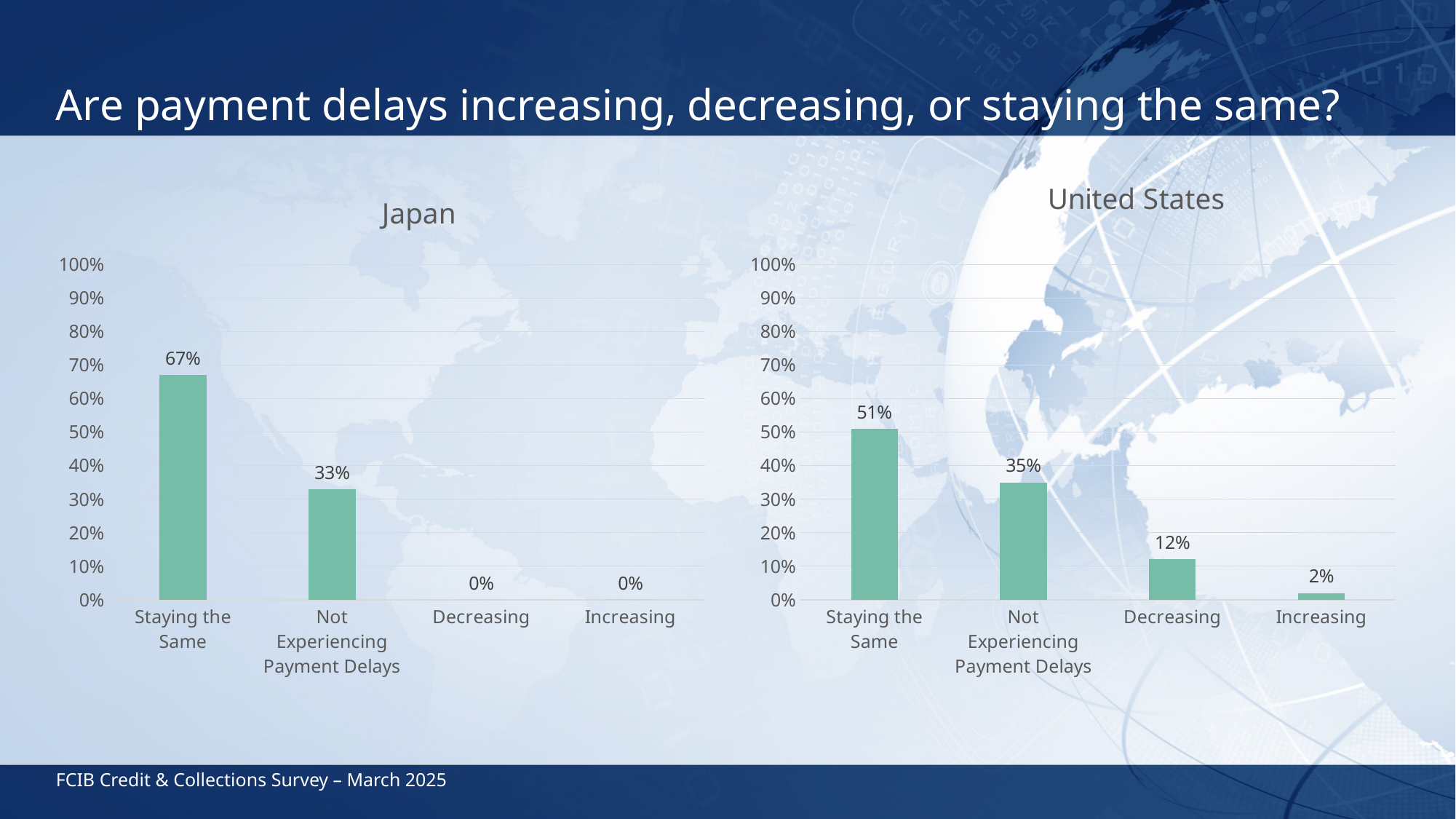
In the Japan chart, what is the value for Decreasing? 0% In the Japan chart, what is the value for Not Experiencing Payment Delays? 33% In the United States chart, which category has the lowest value? Increasing In the United States chart, what is the value for Increasing? 2% In the United States chart, what is the value for Decreasing? 12% In the United States chart, what is the difference between Staying the Same and Not Experiencing Payment Delays? 16% In the Japan chart, what is the value for Staying the Same? 67% In the Japan chart, what is the difference between Staying the Same and Not Experiencing Payment Delays? 34% In the Japan chart, how many categories are shown on the x axis? 4 In the United States chart, which category has the highest value? Staying the Same Which is larger: Staying the Same in the Japan chart or Staying the Same in the United States chart? Japan What kind of chart is the United States chart? Bar chart